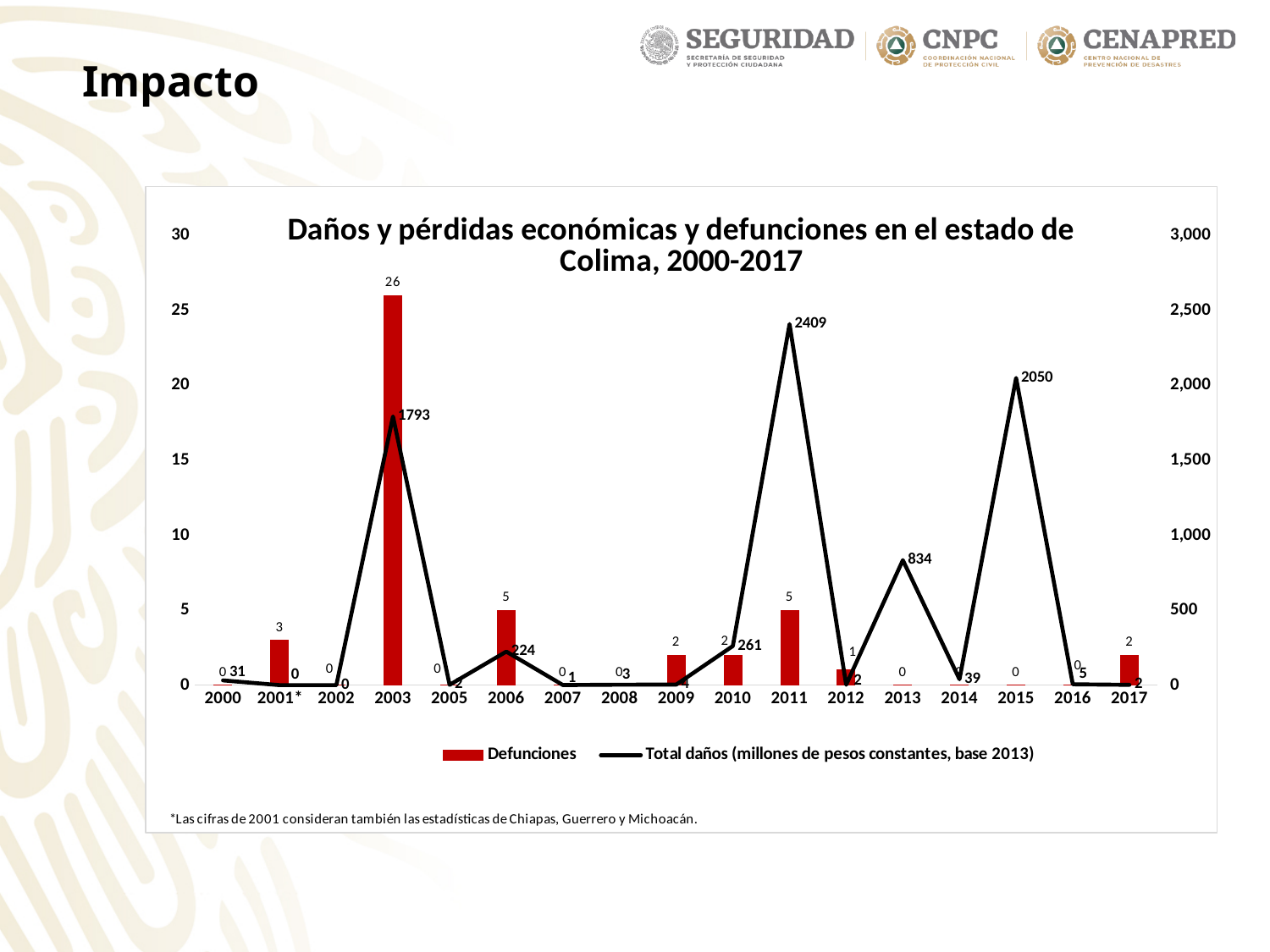
Which year has the highest Total daños value? 2011 What is the value of Total daños for 2013? 834 Which year has the highest number of Defunciones? 2003 How many years are shown on the x axis of the chart? 17 How many deaths (Defunciones) are shown for 2003? 26 What is the difference between the Defunciones values for 2003 and 2006? 21 How many deaths (Defunciones) are shown for 2006? 5 How many series does the legend list? 2 What is the difference between the Total daños values for 2011 and 2015? 359 Is the Total daños value for 2003 greater or less than 1,500? greater What is the value of Total daños (millones de pesos constantes, base 2013) for 2011? 2409 Which year has a larger Total daños value, 2003 or 2015? 2015